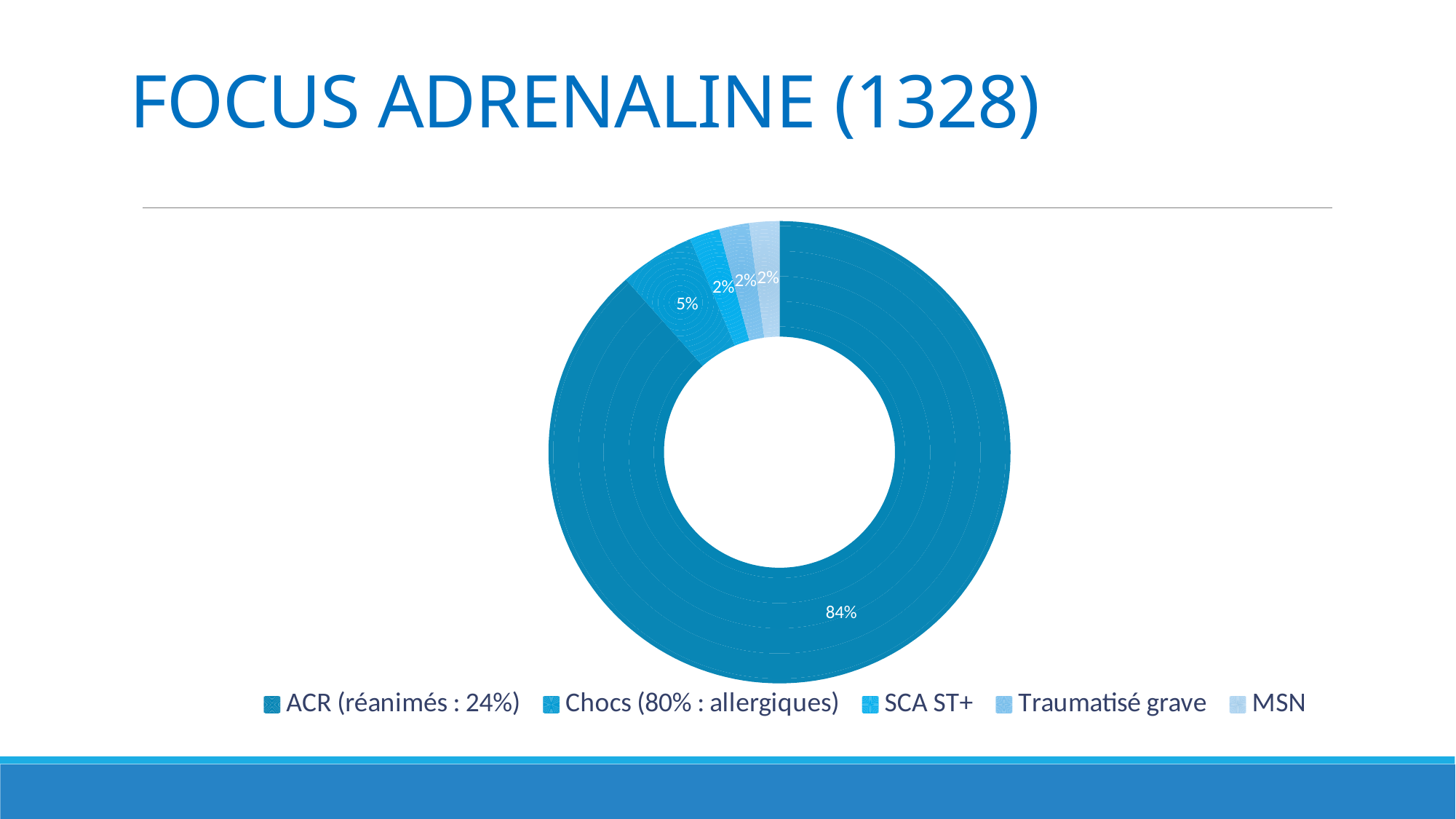
Which category has the largest share of the doughnut chart? ACR (réanimés : 24%) Which legend entry is listed last in the doughnut chart's legend? MSN What share of the doughnut chart does SCA ST+ represent? 2% Which is larger, the share for Chocs (80% : allergiques) or the share for Traumatisé grave? Chocs (80% : allergiques) What share of the doughnut chart does Chocs (80% : allergiques) represent? 5% What kind of chart is shown on the slide? Doughnut chart How many categories in the doughnut chart have a share of 2%? 3 What is the title of the slide containing the doughnut chart? FOCUS ADRENALINE (1328) What share of the doughnut chart does ACR (réanimés : 24%) represent? 84% What is the difference in percentage points between the ACR (réanimés : 24%) share and the Chocs (80% : allergiques) share? 79 What share of the doughnut chart does MSN represent? 2% How many categories does the legend of the doughnut chart list? 5